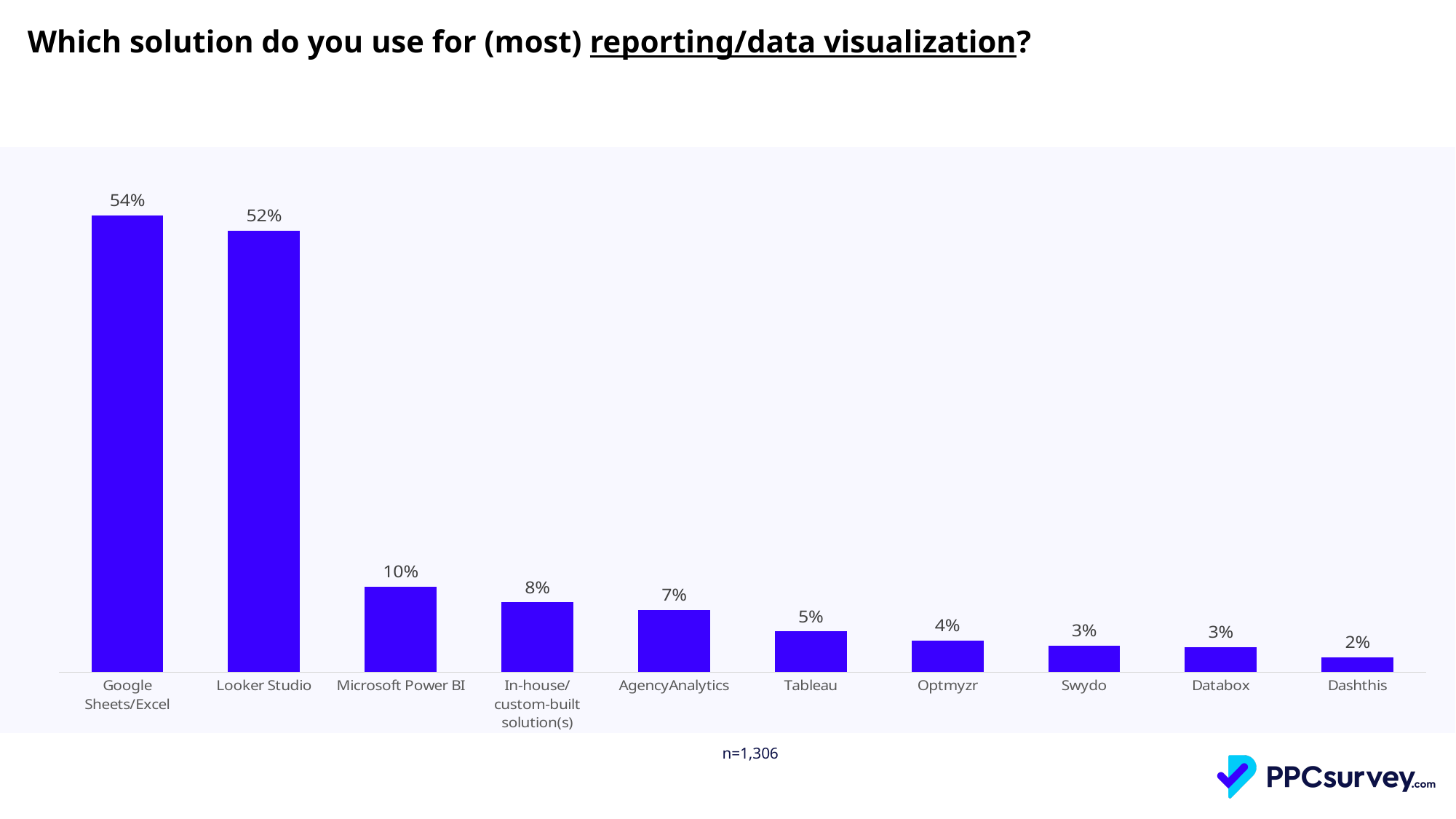
How many solutions are shown on the chart? 10 What is the difference between the values for Microsoft Power BI and AgencyAnalytics? 3% Which solution has the highest percentage? Google Sheets/Excel Which solution has the lowest percentage? Dashthis What is the value for Tableau? 5% What percentage of respondents use Google Sheets/Excel for reporting/data visualization? 54% Which has a higher value, In-house/custom-built solution(s) or Tableau? In-house/custom-built solution(s) What sample size (n) is stated below the chart? n=1,306 What is the difference between the values for Google Sheets/Excel and Looker Studio? 2% What percentage is shown for Microsoft Power BI? 10% What is the value shown for Looker Studio? 52% What kind of chart is shown on the slide? Bar chart